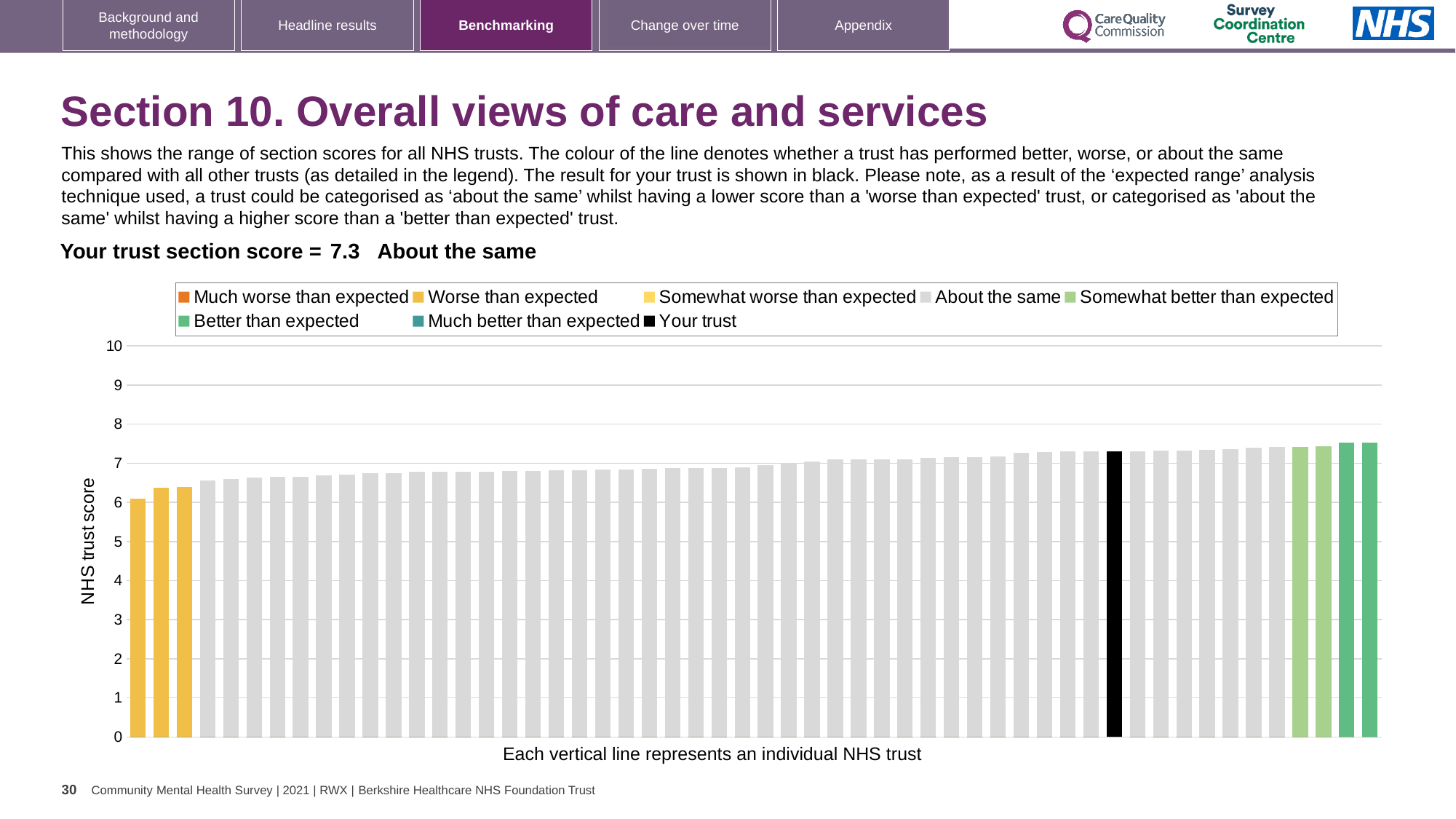
What category does the black bar represent according to the legend? Your trust What kind of chart is shown on the slide? bar chart How many bars are coloured as 'Worse than expected' (yellow)? 3 What is the label on the vertical axis of the chart? NHS trust score How many entries does the chart legend list? 8 Is the value of the black 'Your trust' bar greater or less than 7? greater Is the value of the highest bar in the chart greater or less than 8? less Which category is your trust placed in according to the slide? About the same Do the bar values rise or fall from left to right across the chart? rise What is the section score for your trust shown on the slide? 7.3 Is the value of the lowest bar in the chart greater or less than 7? less